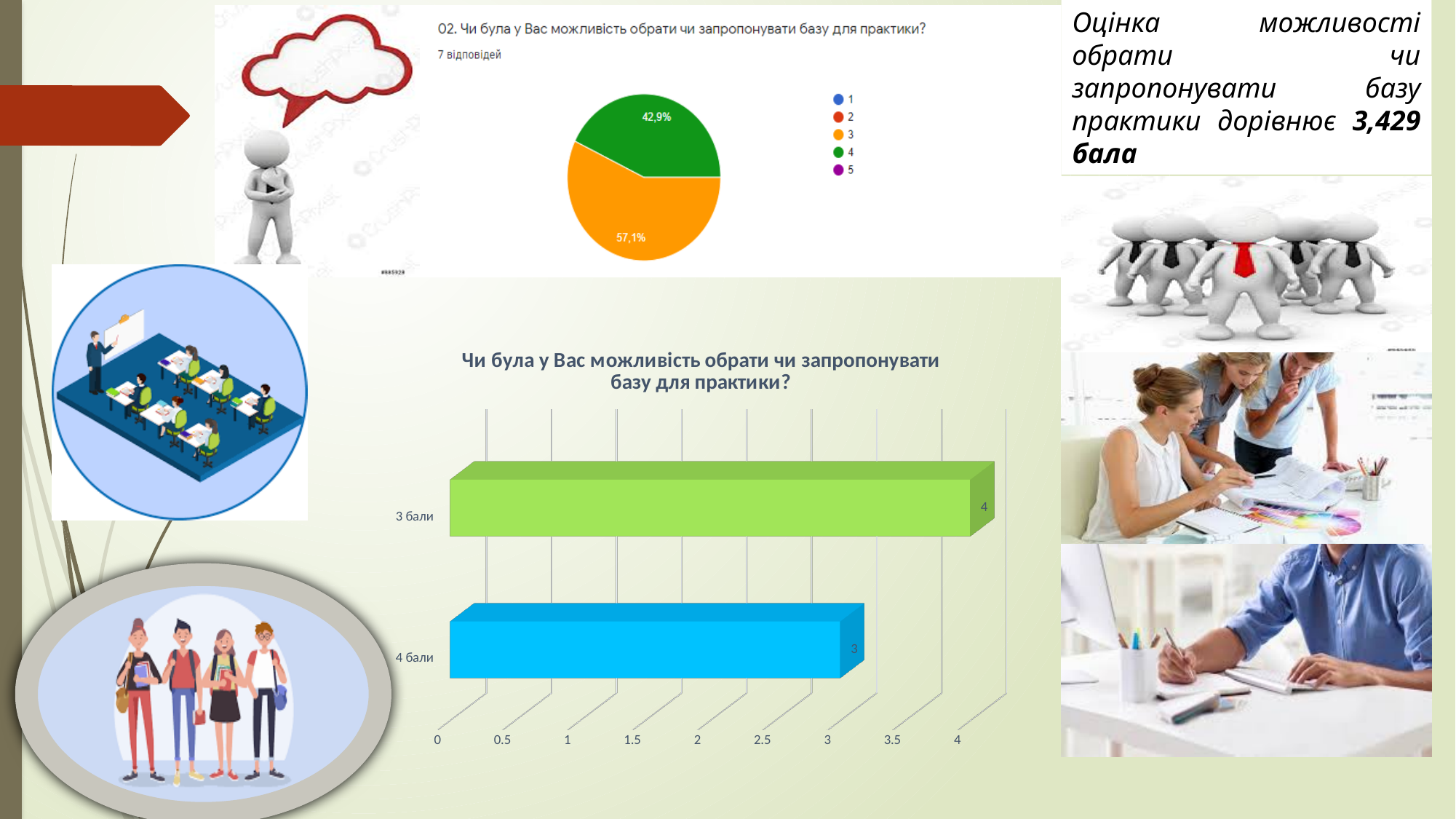
On the bar chart at the bottom of the slide, what is the value for "3 бали"? 4 On the pie chart at the top of the slide, what share is shown for the orange slice (rating 3)? 57,1% On the bar chart at the bottom of the slide, what is the difference between the values for "3 бали" and "4 бали"? 1 On the pie chart at the top of the slide, what share is shown for the green slice (rating 4)? 42,9% On the bar chart at the bottom of the slide, what is the value for "4 бали"? 3 On the bar chart at the bottom of the slide, which is larger: the value for "3 бали" or the value for "4 бали"? 3 бали What kind of chart is the chart at the bottom of the slide? Bar chart On the bar chart at the bottom of the slide, which category has the lowest value? 4 бали On the bar chart at the bottom of the slide, how many categories are plotted? 2 On the bar chart at the bottom of the slide, which category has the highest value? 3 бали On the pie chart at the top of the slide, how many responses are reported under the question title? 7 відповідей On the pie chart at the top of the slide, how many entries does the legend list? 5